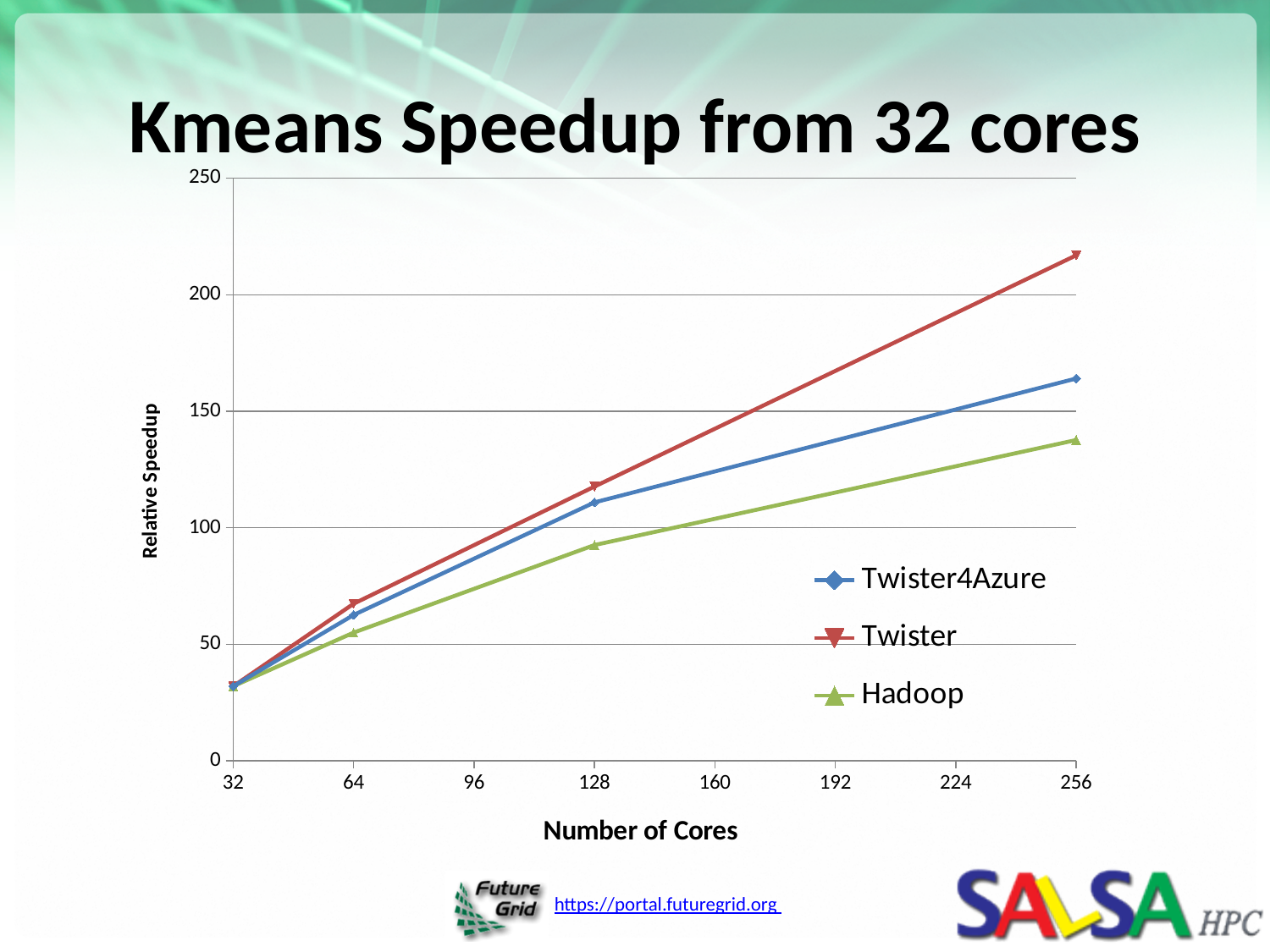
Which series has the highest relative speedup at 256 cores? Twister What is the label of the x axis? Number of Cores Is the relative speedup for Hadoop at 256 cores greater or less than 150? less Does the relative speedup for Twister rise or fall as the number of cores increases? rise How many data points are plotted for the Hadoop series? 4 How many series does the legend list? 3 Is the relative speedup for Twister at 256 cores greater or less than 200? greater What kind of chart is shown on the slide? line chart At 256 cores, which has the larger relative speedup, Twister4Azure or Hadoop? Twister4Azure Is the relative speedup for Twister4Azure at 128 cores greater or less than 100? greater Which series has the lowest relative speedup at 256 cores? Hadoop